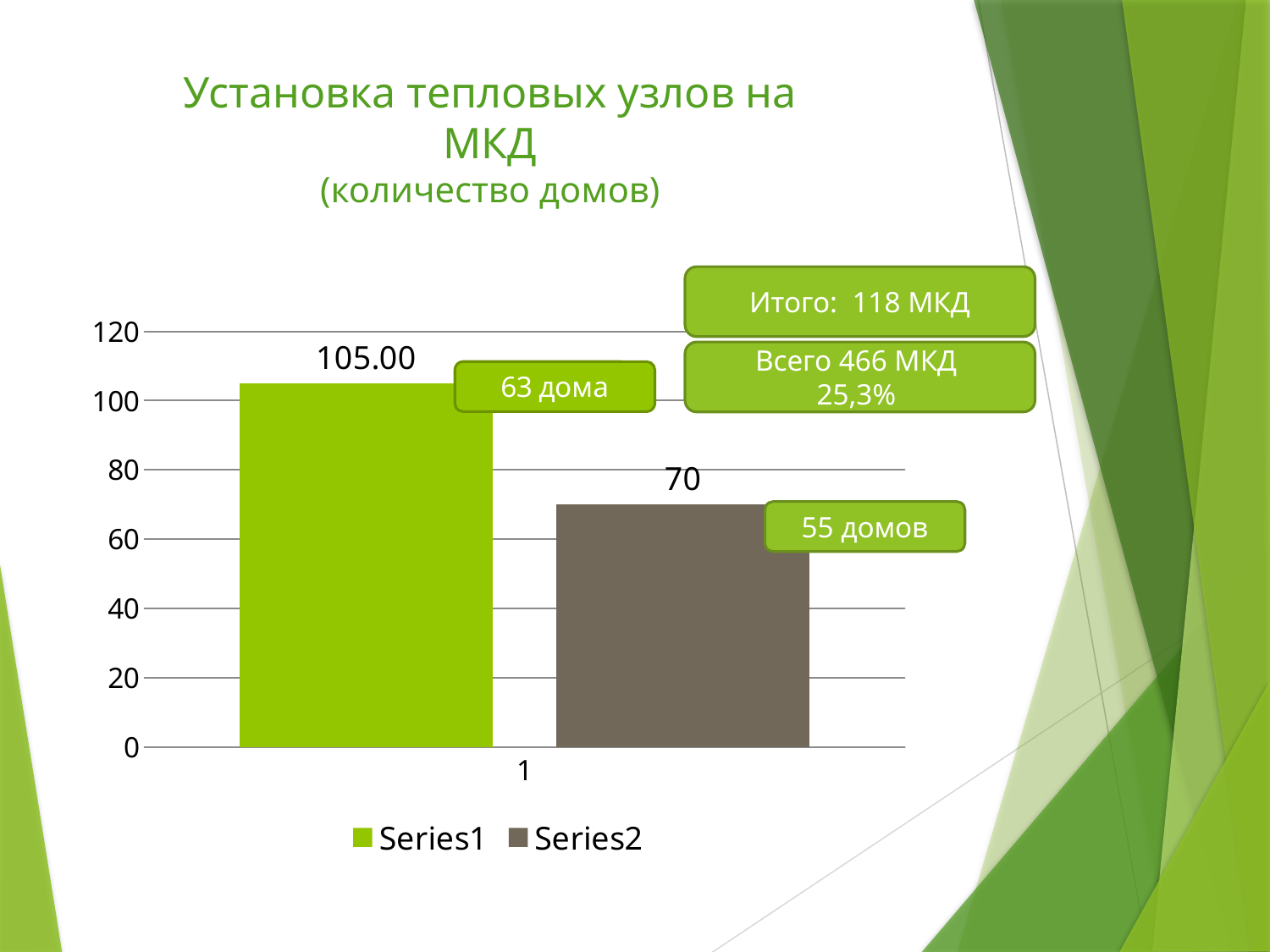
Which series has the higher bar, Series1 or Series2? Series1 Is the value for Series2 greater or less than 80? less What kind of chart is shown on the slide? bar chart What is the value of Series2 in the chart? 70 How many series does the legend list? 2 What is the highest value shown on the vertical axis of the chart? 120 What is the title of the chart on the slide? Установка тепловых узлов на МКД (количество домов) How many categories are shown on the x axis? 1 What is the difference between the Series1 value and the Series2 value? 35 What is the value of Series1 in the chart? 105.00 Which series has the lowest value in the chart? Series2 Is the value for Series1 greater or less than 100? greater